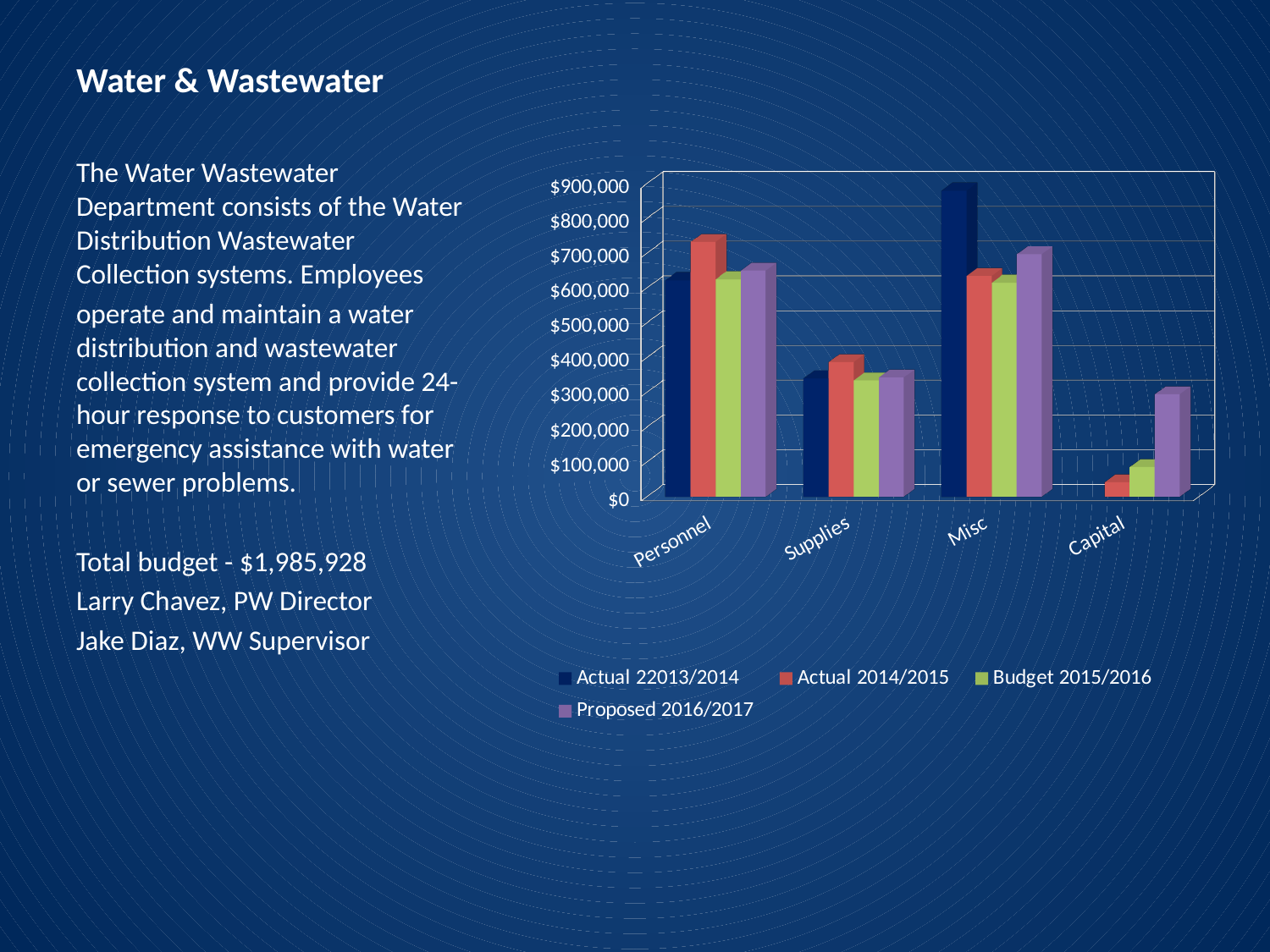
For Misc, which is larger: Actual 22013/2014 or Actual 2014/2015? Actual 22013/2014 Which category has the tallest bar for the Actual 22013/2014 series? Misc Is the Proposed 2016/2017 value for Capital greater or less than $400,000? less Is the Actual 2014/2015 value for Capital greater or less than $100,000? less How many categories are shown on the x axis of the chart? 4 Is the Actual 2014/2015 value for Personnel greater or less than $700,000? greater What kind of chart is shown on the slide? Bar chart Which series is shown in purple in the chart legend? Proposed 2016/2017 For the Proposed 2016/2017 series, which is larger: Personnel or Supplies? Personnel How many series does the chart legend list? 4 Which category has the lowest values across all series? Capital